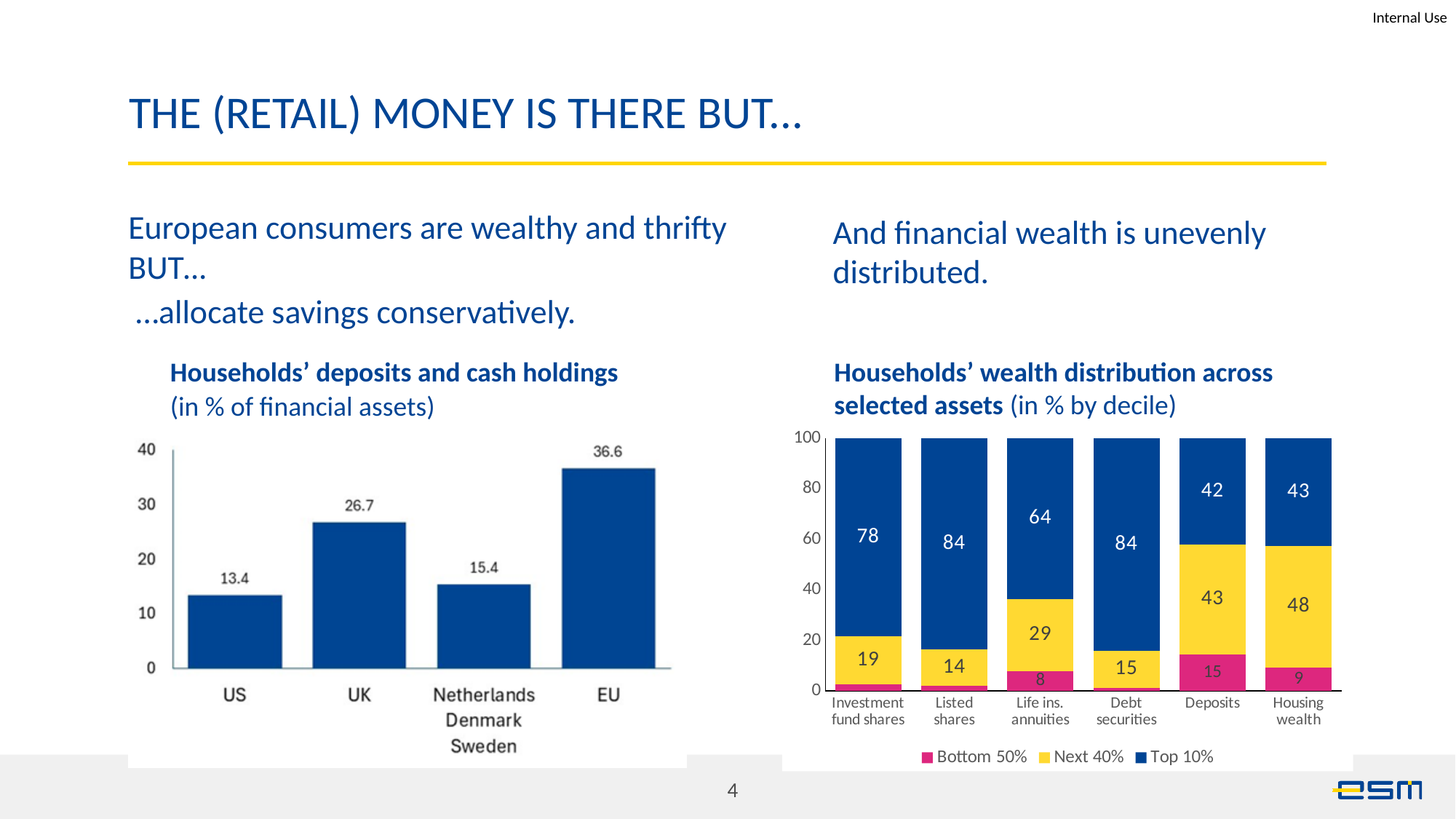
In the 'Households' deposits and cash holdings' chart, how many categories are shown? 4 In the 'Households' wealth distribution across selected assets' chart, what is the Top 10% value for Life ins. annuities? 64 In the 'Households' wealth distribution across selected assets' chart, how many series does the legend list? 3 In the 'Households' deposits and cash holdings' chart, what is the value for the EU? 36.6 In the 'Households' deposits and cash holdings' chart, is the value for Netherlands Denmark Sweden greater or less than 20? less In the 'Households' wealth distribution across selected assets' chart, is the Top 10% value larger for Listed shares or for Deposits? Listed shares In the 'Households' deposits and cash holdings' chart, which category has the lowest value? US What kind of chart is the 'Households' wealth distribution across selected assets' chart? Stacked bar chart In the 'Households' deposits and cash holdings' chart, what is the difference between the EU and US values? 23.2 In the 'Households' wealth distribution across selected assets' chart, what is the Next 40% value for Housing wealth? 48 In the 'Households' wealth distribution across selected assets' chart, which category has the highest Next 40% value? Housing wealth In the 'Households' deposits and cash holdings' chart, what is the value for the UK? 26.7